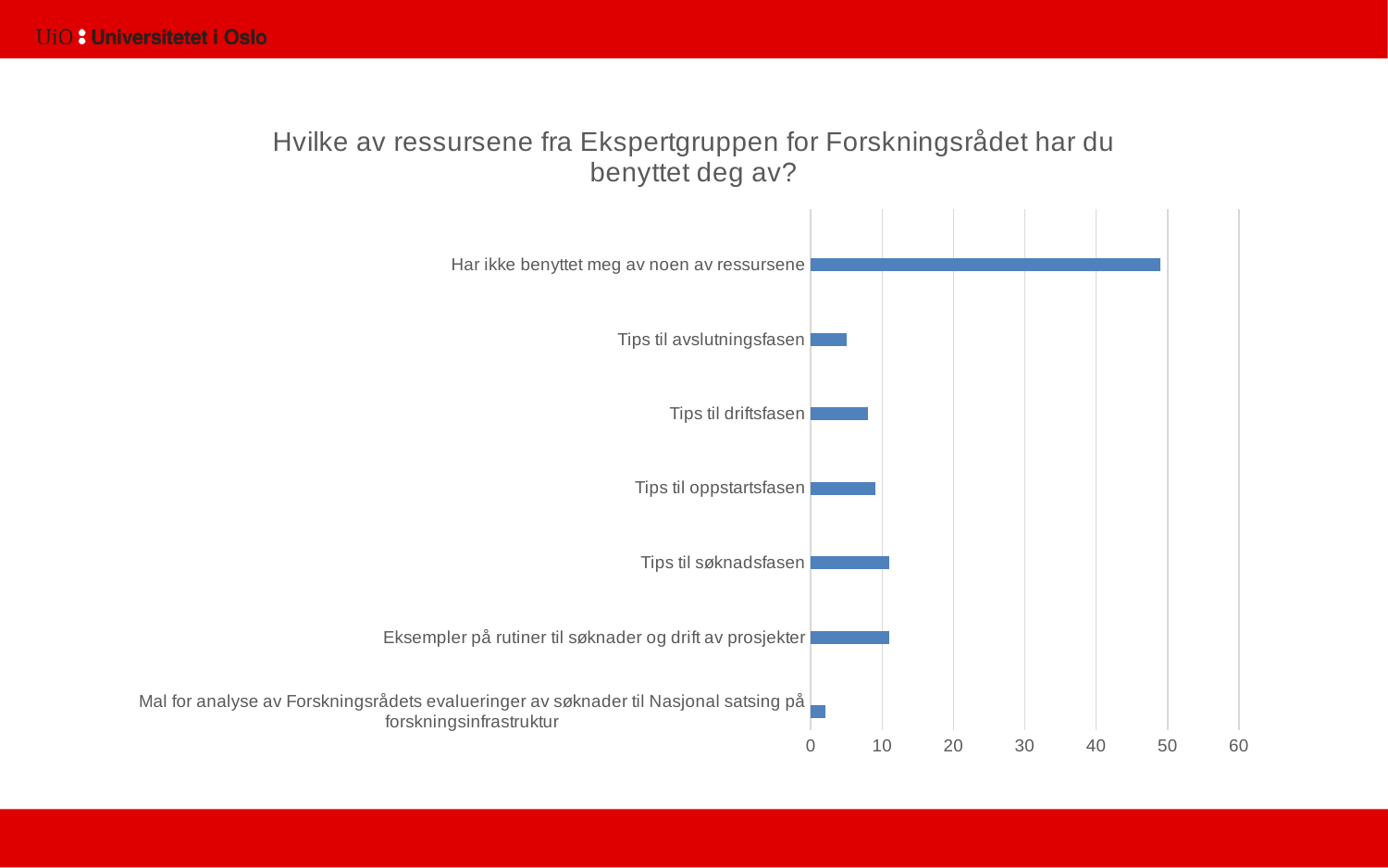
Which category has the lowest value in the chart? Mal for analyse av Forskningsrådets evalueringer av søknader til Nasjonal satsing på forskningsinfrastruktur Is the value for 'Mal for analyse av Forskningsrådets evalueringer av søknader til Nasjonal satsing på forskningsinfrastruktur' greater or less than 10? less Which is larger: the value for 'Tips til oppstartsfasen' or the value for 'Tips til avslutningsfasen'? Tips til oppstartsfasen Which is larger: the value for 'Tips til søknadsfasen' or the value for 'Tips til driftsfasen'? Tips til søknadsfasen Which category has the highest value in the chart? Har ikke benyttet meg av noen av ressursene Which is larger: the value for 'Har ikke benyttet meg av noen av ressursene' or the value for 'Tips til søknadsfasen'? Har ikke benyttet meg av noen av ressursene Is the value for 'Har ikke benyttet meg av noen av ressursene' greater or less than 40? greater How many categories are shown in the chart? 7 What kind of chart is shown on the slide? Bar chart What is the title of the chart? Hvilke av ressursene fra Ekspertgruppen for Forskningsrådet har du benyttet deg av? Is the value for 'Tips til avslutningsfasen' greater or less than 10? less